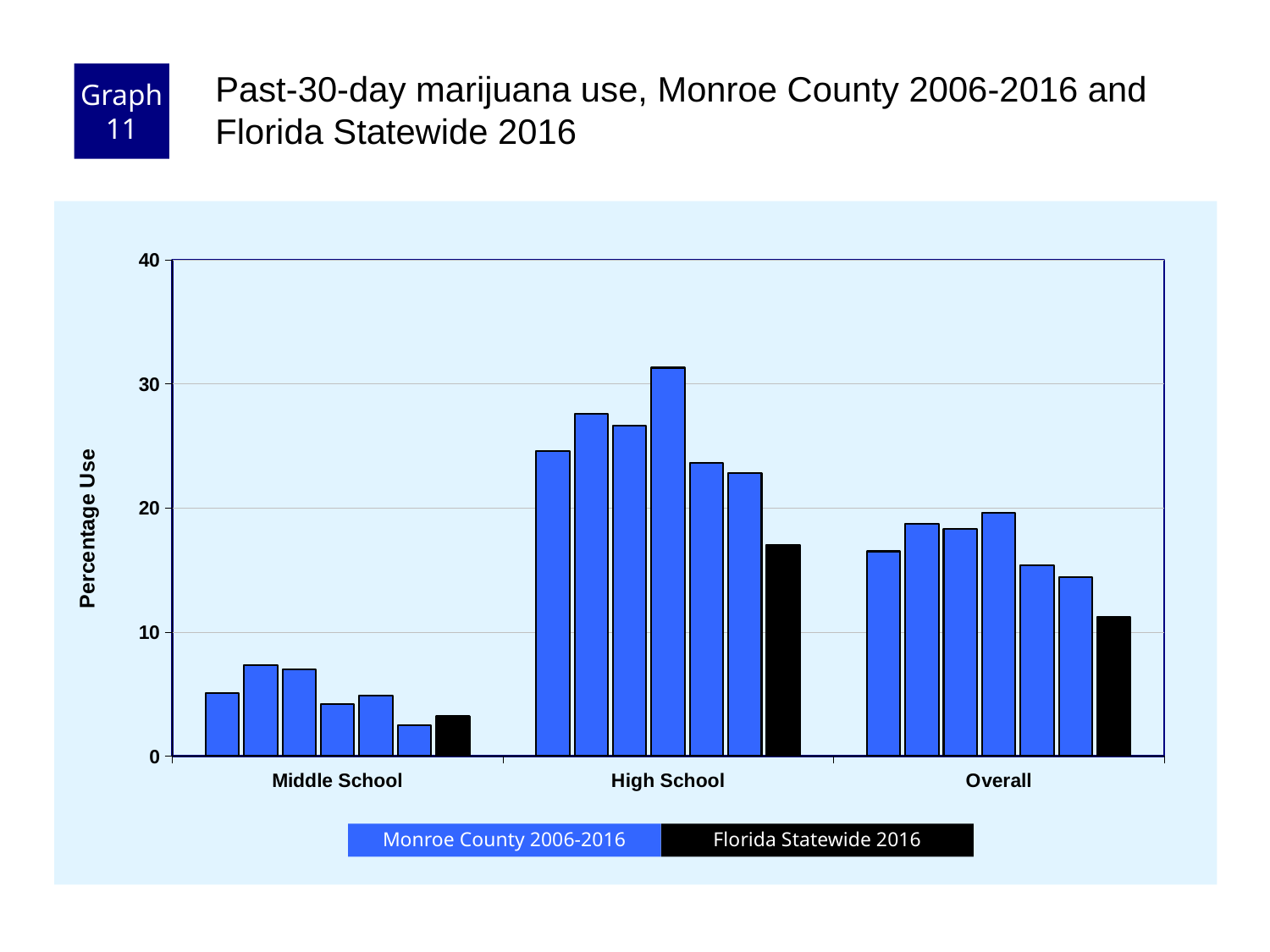
What kind of chart is shown on the slide? bar chart Is the Florida Statewide 2016 value for High School greater or less than 20? less How many series does the legend list? 2 Which is larger, the Florida Statewide 2016 value for High School or for Overall? High School How many categories are shown on the x axis? 3 Is the tallest Monroe County bar for High School greater or less than 30? greater Which category has the highest bars overall? High School Which series is shown in black in the legend? Florida Statewide 2016 Is the Florida Statewide 2016 value for Middle School greater or less than 10? less Which category has the lowest bars overall? Middle School What is the label of the y axis? Percentage Use